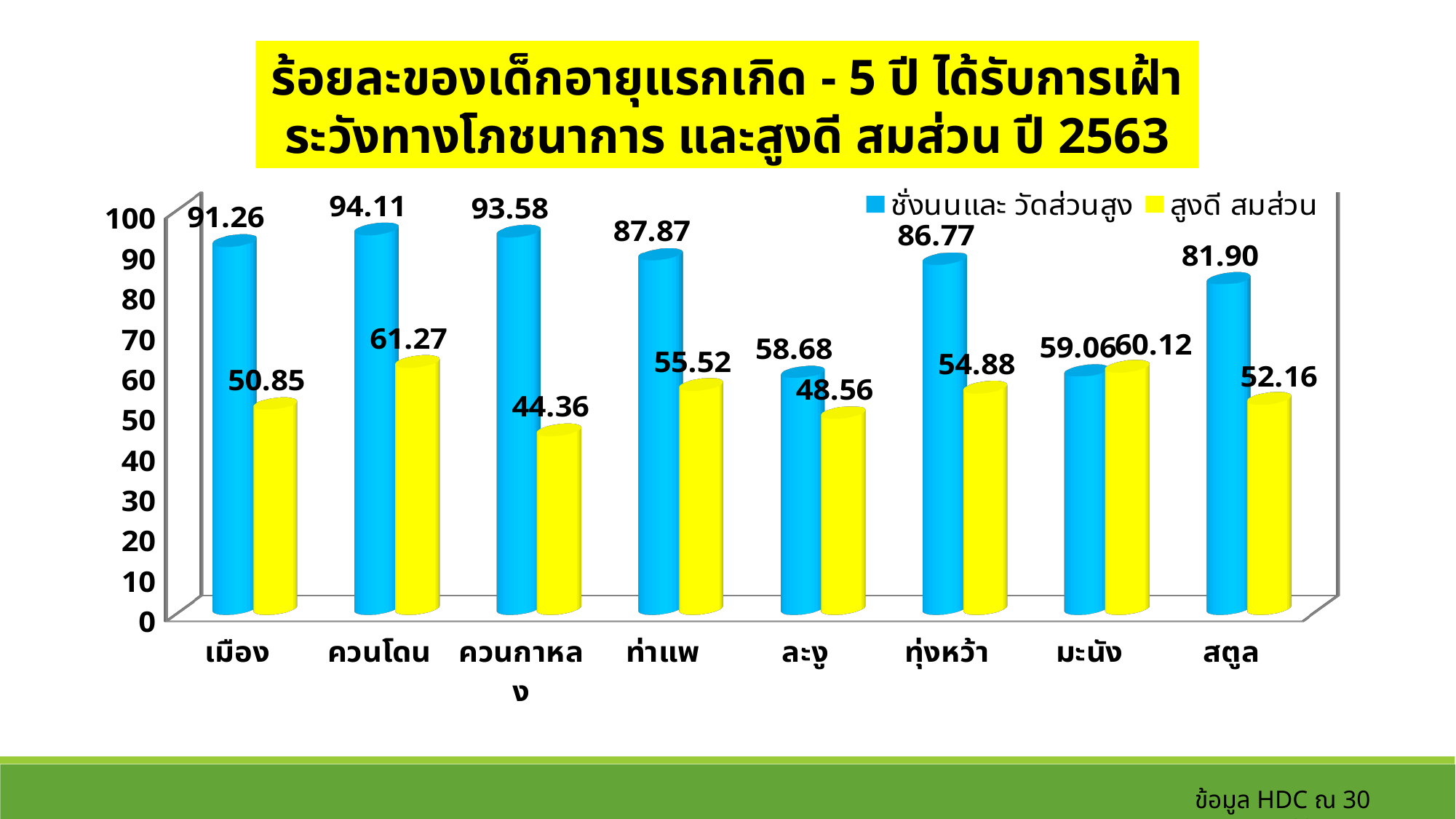
Which category has the lowest value for ชั่งนนและ วัดส่วนสูง? ละงู How many series does the legend list? 2 How many categories are shown on the x axis? 8 What is the value of ชั่งนนและ วัดส่วนสูง for เมือง? 91.26 What is the value of สูงดี สมส่วน for ควนโดน? 61.27 For มะนัง, which series has the larger value: ชั่งนนและ วัดส่วนสูง or สูงดี สมส่วน? สูงดี สมส่วน Which category has the lowest value for สูงดี สมส่วน? ควนกาหลง What kind of chart is shown on the slide? Bar chart What is the difference between ชั่งนนและ วัดส่วนสูง and สูงดี สมส่วน for ควนโดน? 32.84 What is the value of สูงดี สมส่วน for ละงู? 48.56 Is the value of ชั่งนนและ วัดส่วนสูง for สตูล greater or less than 70? greater Which category has the highest value for ชั่งนนและ วัดส่วนสูง? ควนโดน